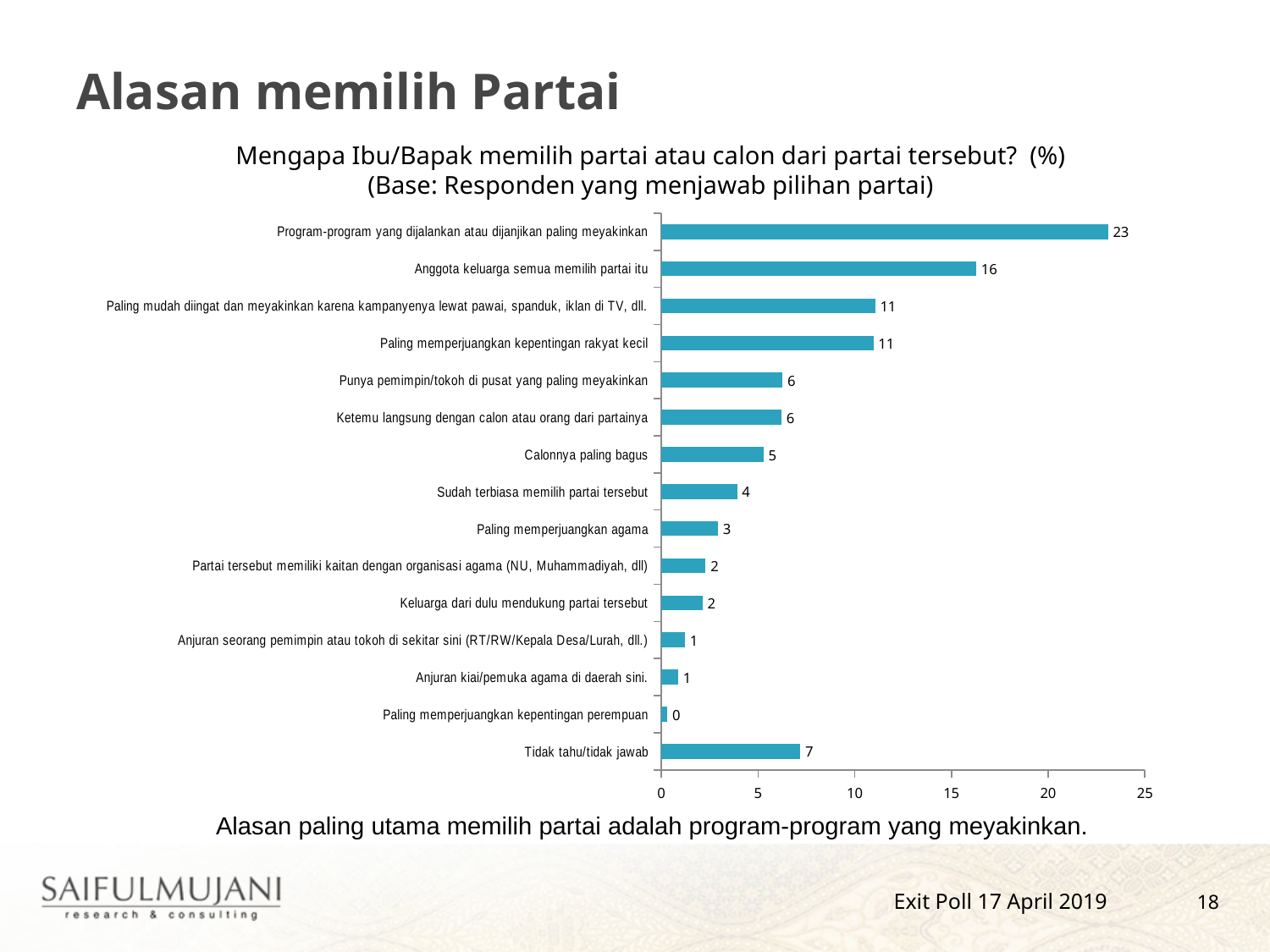
What is the value for "Calonnya paling bagus"? 5 What is the value for "Tidak tahu/tidak jawab"? 7 Which category has the lowest value? Paling memperjuangkan kepentingan perempuan Which category has the highest value? Program-program yang dijalankan atau dijanjikan paling meyakinkan What kind of chart is shown on the slide? Bar chart What is the value for "Program-program yang dijalankan atau dijanjikan paling meyakinkan"? 23 Which is larger: the value for "Sudah terbiasa memilih partai tersebut" or the value for "Paling memperjuangkan agama"? Sudah terbiasa memilih partai tersebut What is the difference between the values for "Program-program yang dijalankan atau dijanjikan paling meyakinkan" and "Anggota keluarga semua memilih partai itu"? 7 What is the maximum value shown on the horizontal axis? 25 How many categories are shown in the chart? 15 What is the value for "Anggota keluarga semua memilih partai itu"? 16 Is the value for "Anggota keluarga semua memilih partai itu" greater or less than 15? greater